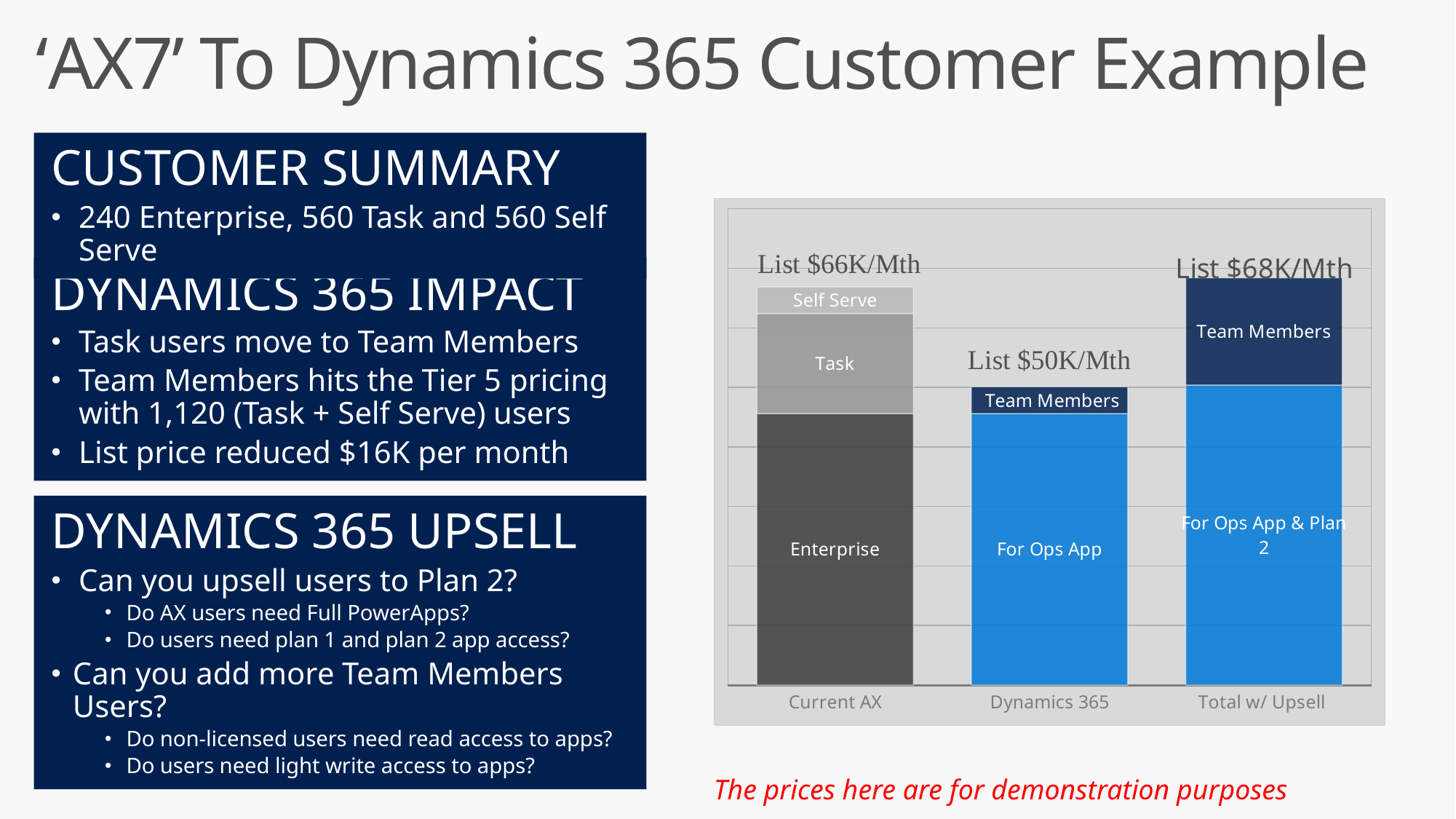
What are the three segments that make up the Current AX bar? Enterprise, Task, Self Serve Which has a higher list price per month, Current AX or Dynamics 365? Current AX What is the list price label shown above the Dynamics 365 bar? List $50K/Mth Which category has the highest list price per month? Total w/ Upsell Which category has the lowest list price per month? Dynamics 365 What is the difference between the Total w/ Upsell and Current AX list prices per month? $2K What kind of chart is shown on the slide? Stacked bar chart How many categories are shown on the x axis of the chart? 3 What is the label of the bottom segment of the Total w/ Upsell bar? For Ops App & Plan 2 What is the list price label shown above the Current AX bar? List $66K/Mth By how much does the Current AX list price exceed the Dynamics 365 list price per month? $16K What is the list price label shown above the Total w/ Upsell bar? List $68K/Mth